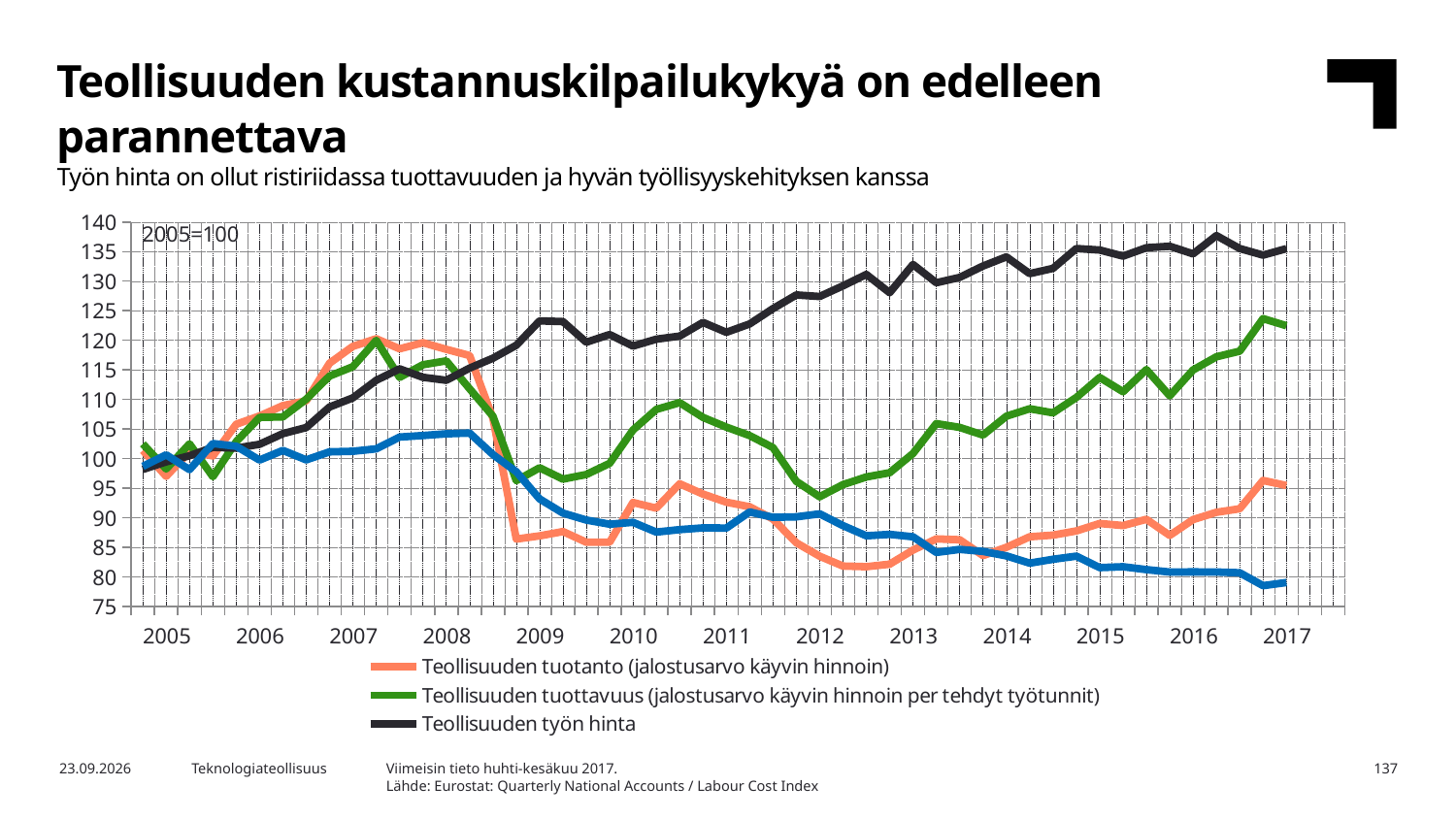
Is the value for Teollisuuden tuottavuus in 2012 greater or less than 100? less What base-year index note is printed inside the chart area? 2005=100 Is the value for Teollisuuden tuottavuus in 2017 greater or less than 115? greater What kind of chart is shown on the slide? line chart Is the value for Teollisuuden tuotanto in 2009 greater or less than 90? less In 2017, which is higher: Teollisuuden työn hinta or Teollisuuden tuotanto? Teollisuuden työn hinta How many series does the legend list? 3 Does Teollisuuden työn hinta rise or fall from 2005 to 2017? rise In 2010, which is higher: Teollisuuden tuottavuus or Teollisuuden tuotanto? Teollisuuden tuottavuus